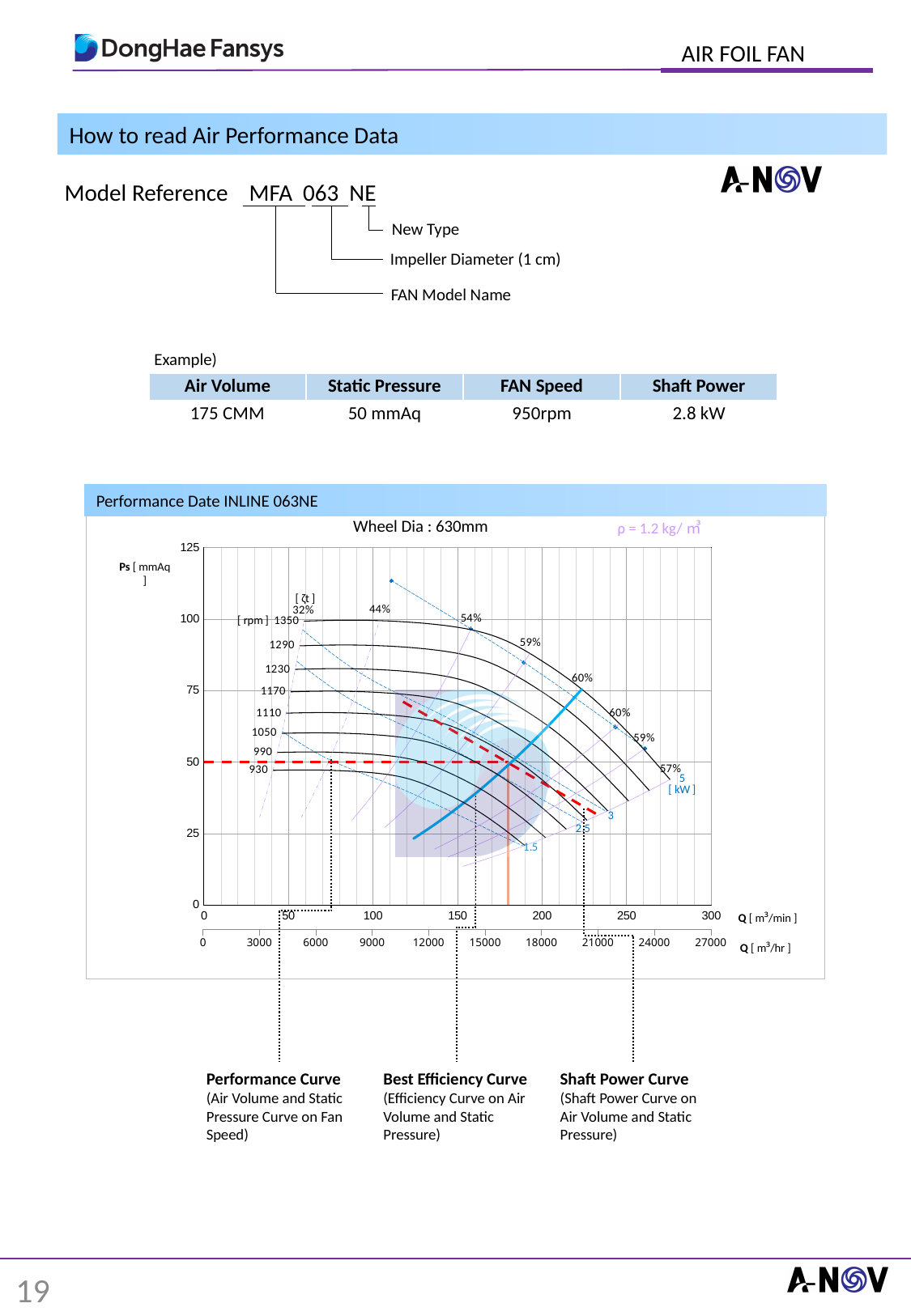
What kind of chart is shown in the Performance Data INLINE 063NE panel? line chart What is the highest fan speed labelled on the performance chart? 1350 rpm What is the largest shaft power value labelled on the performance chart? 5 kW What is the smallest shaft power value labelled on the performance chart? 1.5 kW How many fan speed (rpm) curves are labelled on the performance chart? 8 Along each rpm curve on the performance chart, does static pressure rise or fall as air volume increases? fall At what static pressure (mmAq) is the horizontal red dashed line drawn on the performance chart? 50 What is the lowest fan speed labelled on the performance chart? 930 rpm What is the lowest efficiency value labelled on the performance chart? 32% What is the maximum air volume shown on the Q [m³/hr] axis of the performance chart? 27000 What is the maximum value shown on the static pressure (Ps) axis of the performance chart? 125 What is the highest efficiency value labelled on the performance chart? 60%